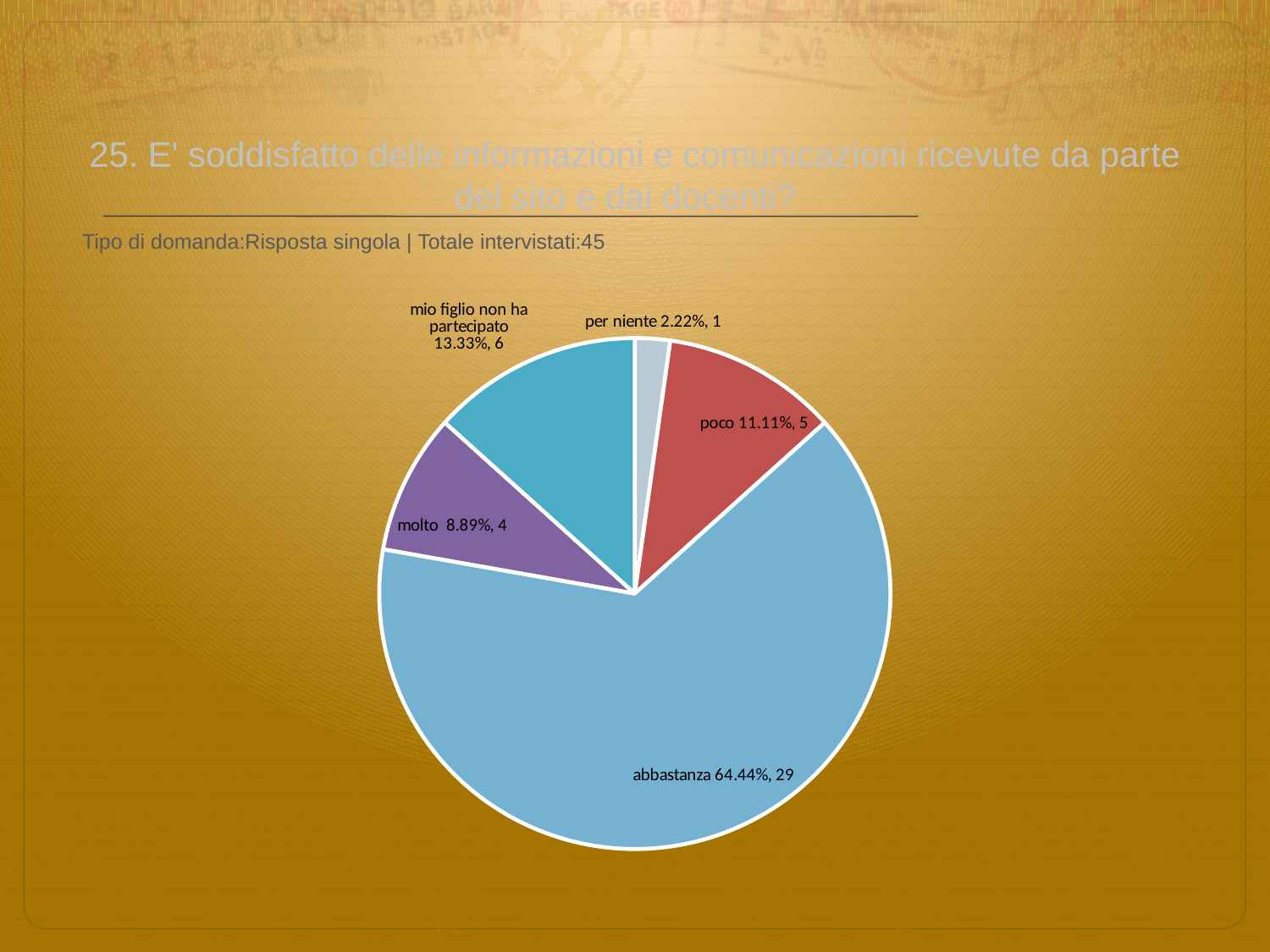
What percentage share does the 'abbastanza' slice have? 64.44% How many respondents answered 'poco'? 5 How many slices does the pie chart have? 5 Which has more respondents, 'molto' or 'mio figlio non ha partecipato'? mio figlio non ha partecipato Which category has the largest slice? abbastanza What is the total number of respondents stated on the slide? 45 Which category has the smallest slice? per niente What percentage share does the 'per niente' slice have? 2.22% What is the difference in respondent count between 'abbastanza' and 'poco'? 24 How many respondents answered 'molto'? 4 What kind of chart is shown on the slide? pie chart What percentage share does the 'mio figlio non ha partecipato' slice have? 13.33%